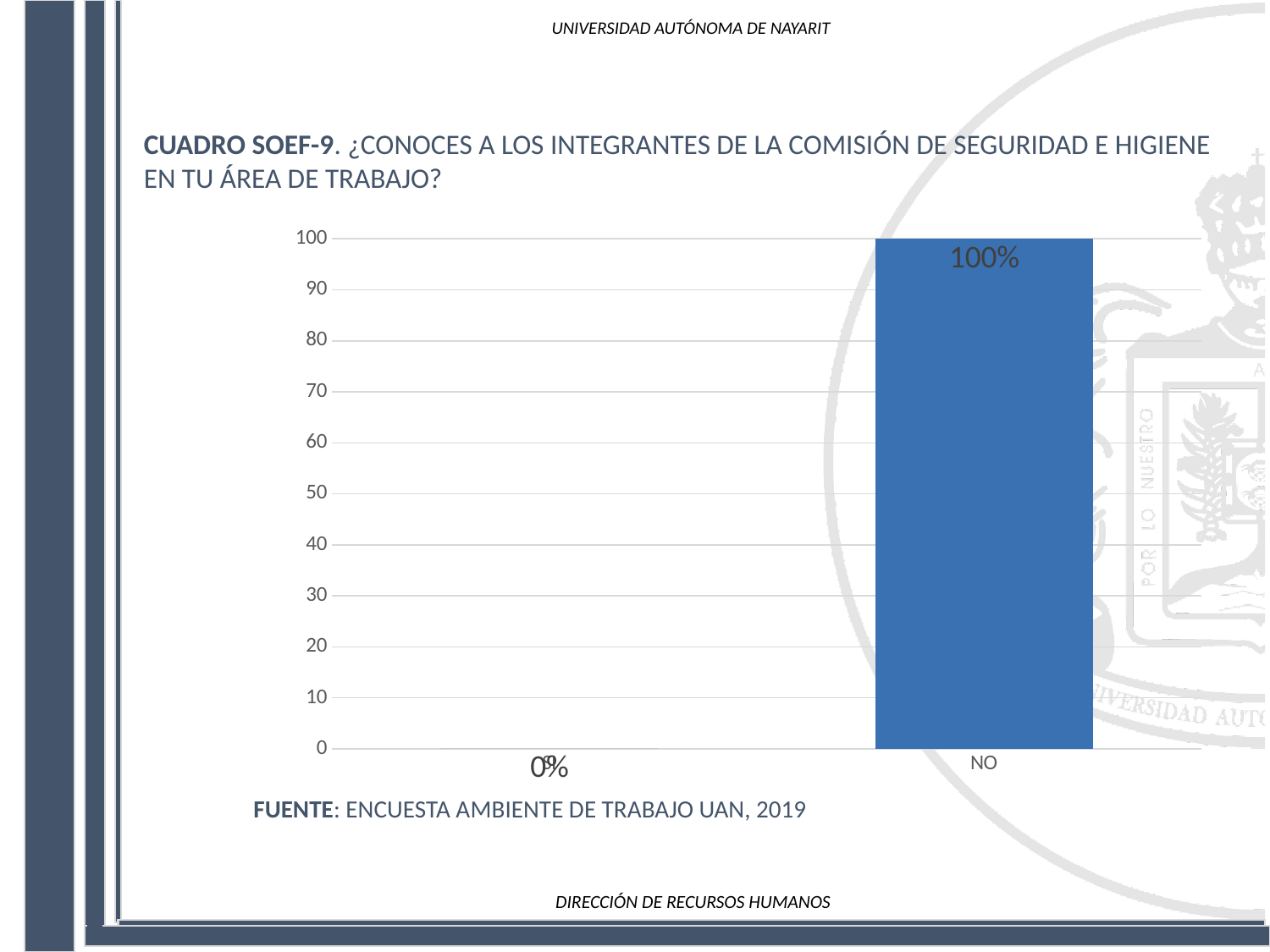
What is the source cited below the chart? ENCUESTA AMBIENTE DE TRABAJO UAN, 2019 What is the highest value shown on the vertical axis? 100 How many categories are plotted in the chart? 2 What kind of chart is shown on the slide? bar chart What is the difference between the value for NO and the other category's value of 0%? 100% Is the value for NO greater or less than 50? greater Which category has the highest value? NO What is the value for NO? 100%